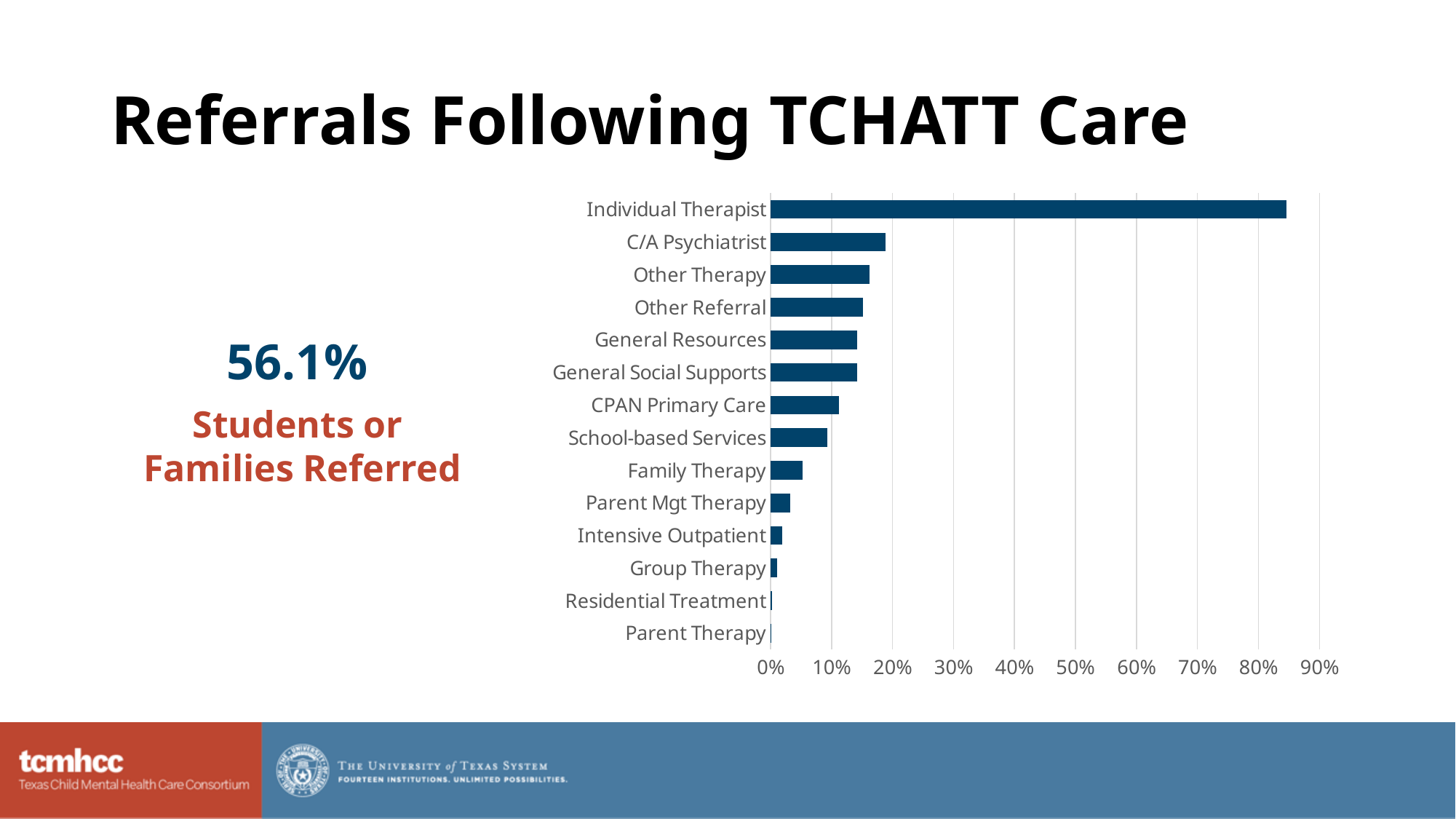
What is the highest percentage tick shown on the chart's horizontal axis? 90% Which is larger, the value for School-based Services or the value for Family Therapy? School-based Services How many referral categories are listed in the chart? 14 Which referral category has the highest value in the chart? Individual Therapist Is the value for Other Therapy greater or less than 10%? greater Is the value for Family Therapy greater or less than 10%? less Is the value for Individual Therapist greater or less than 80%? greater What is the title of the slide containing the chart? Referrals Following TCHATT Care Which is larger, the value for Individual Therapist or the value for C/A Psychiatrist? Individual Therapist What kind of chart is shown on the slide? bar chart